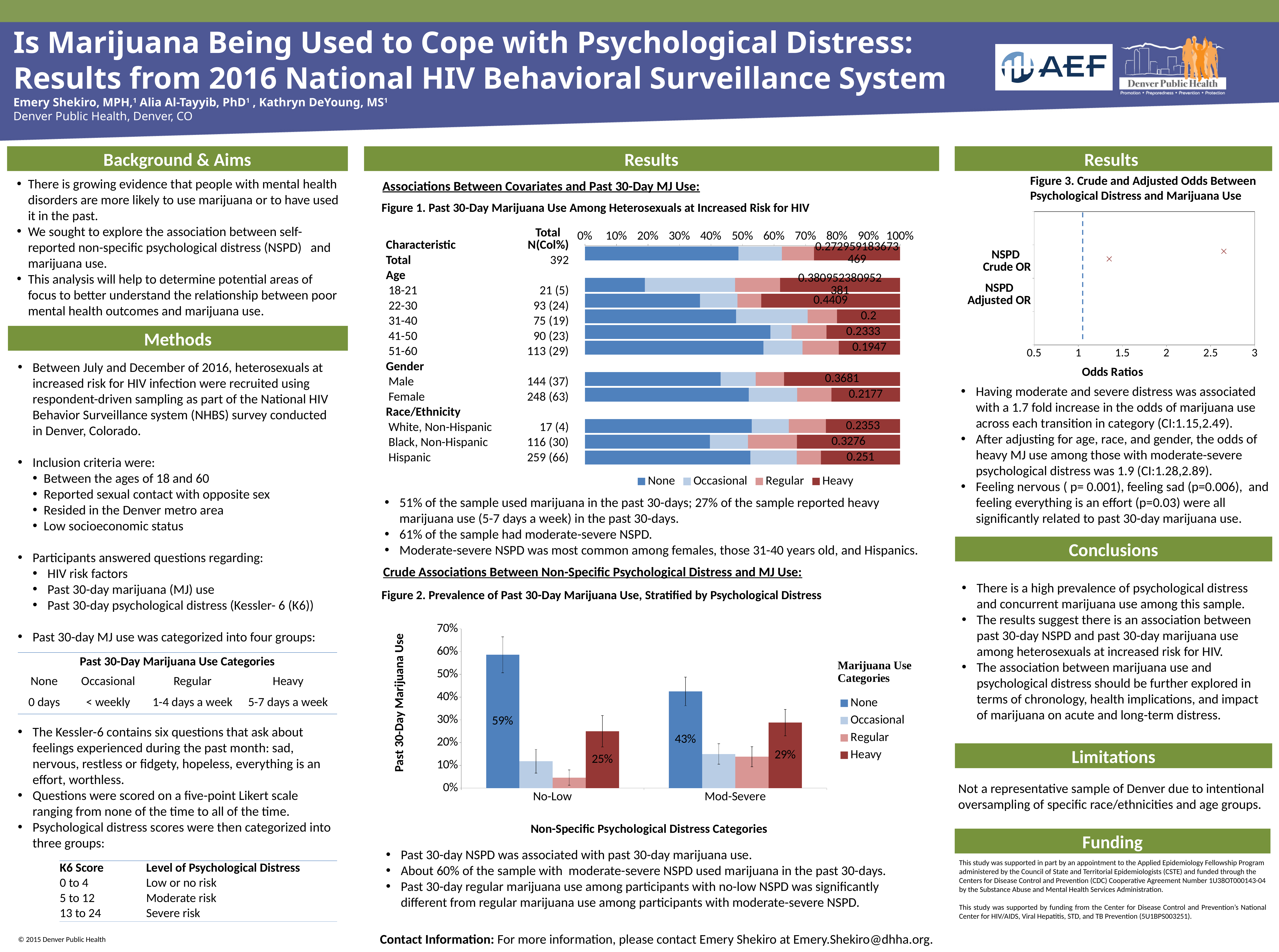
In Figure 1, what is the data label shown on the Heavy segment for the 22-30 age group? 0.4409 In Figure 2, what is the labeled value for Heavy in the Mod-Severe category? 29% In Figure 2, what is the labeled value for None in the No-Low category? 59% In Figure 2, what kind of chart is shown? bar chart In Figure 1, which race/ethnicity group has the highest labeled Heavy value? Black, Non-Hispanic In Figure 2, what is the difference between the None values for No-Low (59%) and Mod-Severe (43%)? 16% In Figure 2, which is larger: the Heavy value for No-Low or the Heavy value for Mod-Severe? Mod-Severe In Figure 2, is the Occasional value for No-Low greater or less than 20%? less In Figure 1, which age group has the lowest labeled Heavy value? 51-60 In Figure 1, what is the data label shown on the Heavy segment for Male? 0.3681 In Figure 2, how many series does the legend list? 4